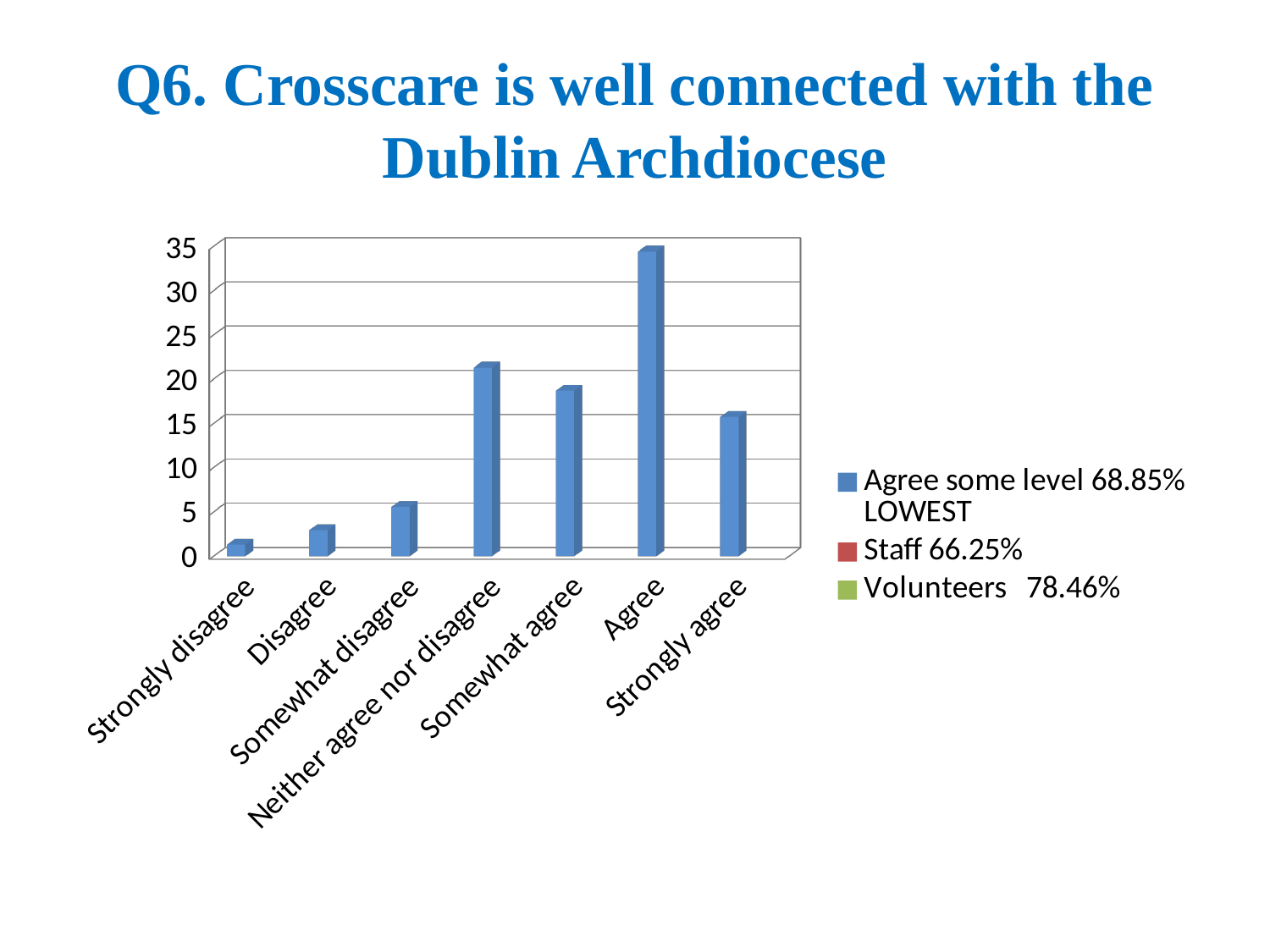
What kind of chart is shown on the slide? bar chart Is the value for Somewhat agree greater or less than 20? less Which category has the highest bar? Agree How many entries does the chart's legend list? 3 Is the value for Strongly agree greater or less than 10? greater Is the value for Agree greater or less than 30? greater How many categories are shown on the x axis of the chart? 7 Which category has the lowest bar? Strongly disagree Which is larger, the value for Neither agree nor disagree or the value for Somewhat agree? Neither agree nor disagree Which is larger, the value for Somewhat agree or the value for Strongly agree? Somewhat agree What percentage does the legend give for Volunteers? 78.46%